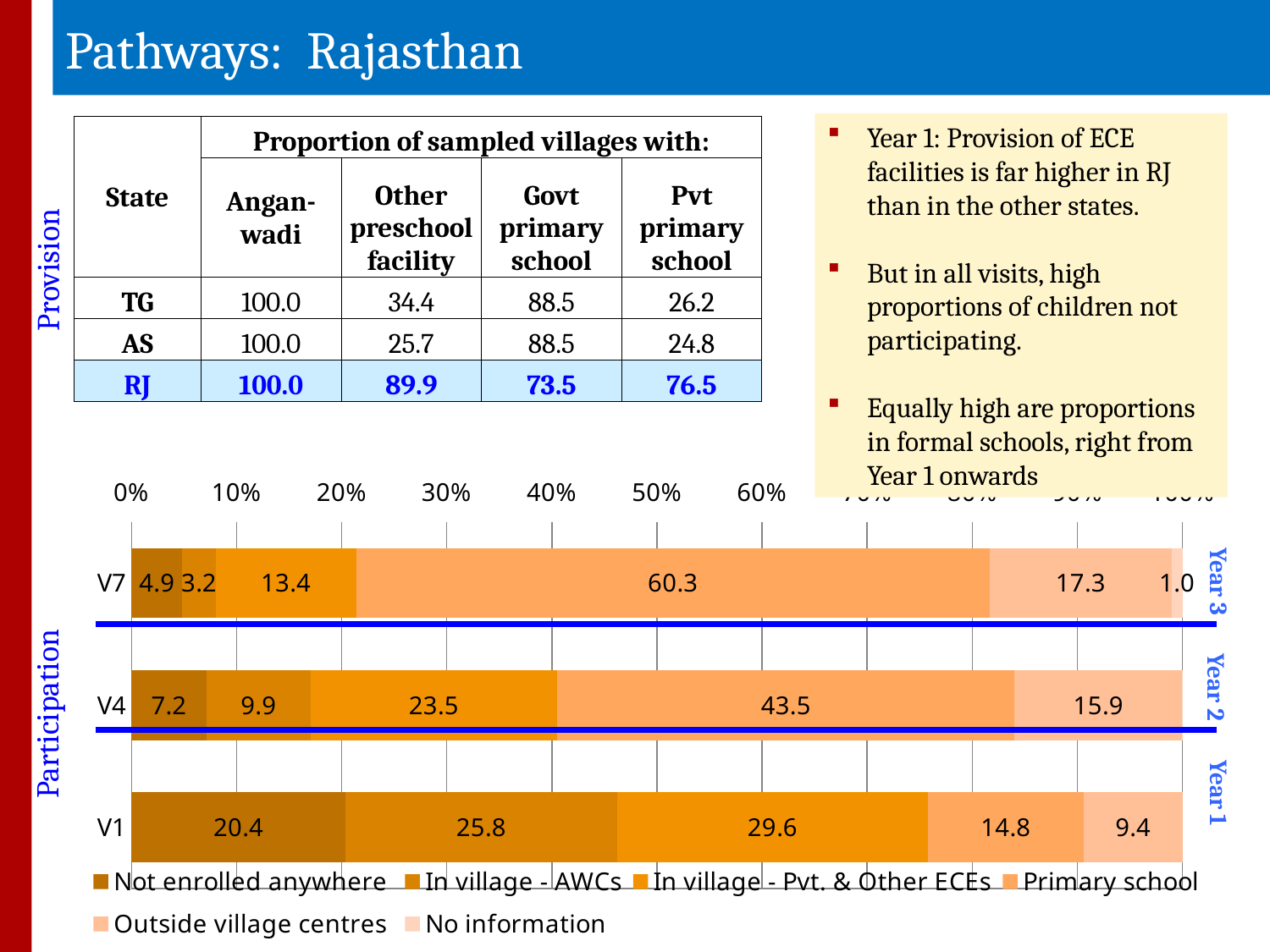
In the bar chart, which visit (V1, V4 or V7) has the highest Primary school value? V7 In the bar chart, what is the difference between the Primary school values for V7 and V1? 45.5 In the bar chart, does the Not enrolled anywhere value rise or fall from V1 to V7? Fall In the bar chart, what is the value for In village - Pvt. & Other ECEs in V4? 23.5 In the bar chart, what is the value for Not enrolled anywhere in V1? 20.4 How many bars (visits) are shown in the bar chart? 3 In the bar chart, what is the value for Outside village centres in V4? 15.9 In the bar chart, which visit (V1, V4 or V7) has the lowest Not enrolled anywhere value? V7 How many series does the legend of the bar chart list? 6 What type of chart is shown at the bottom of the slide? Stacked bar chart In the bar chart, what is the value for Primary school in V7? 60.3 In the bar chart, which is larger: In village - AWCs for V1 or for V4? V1